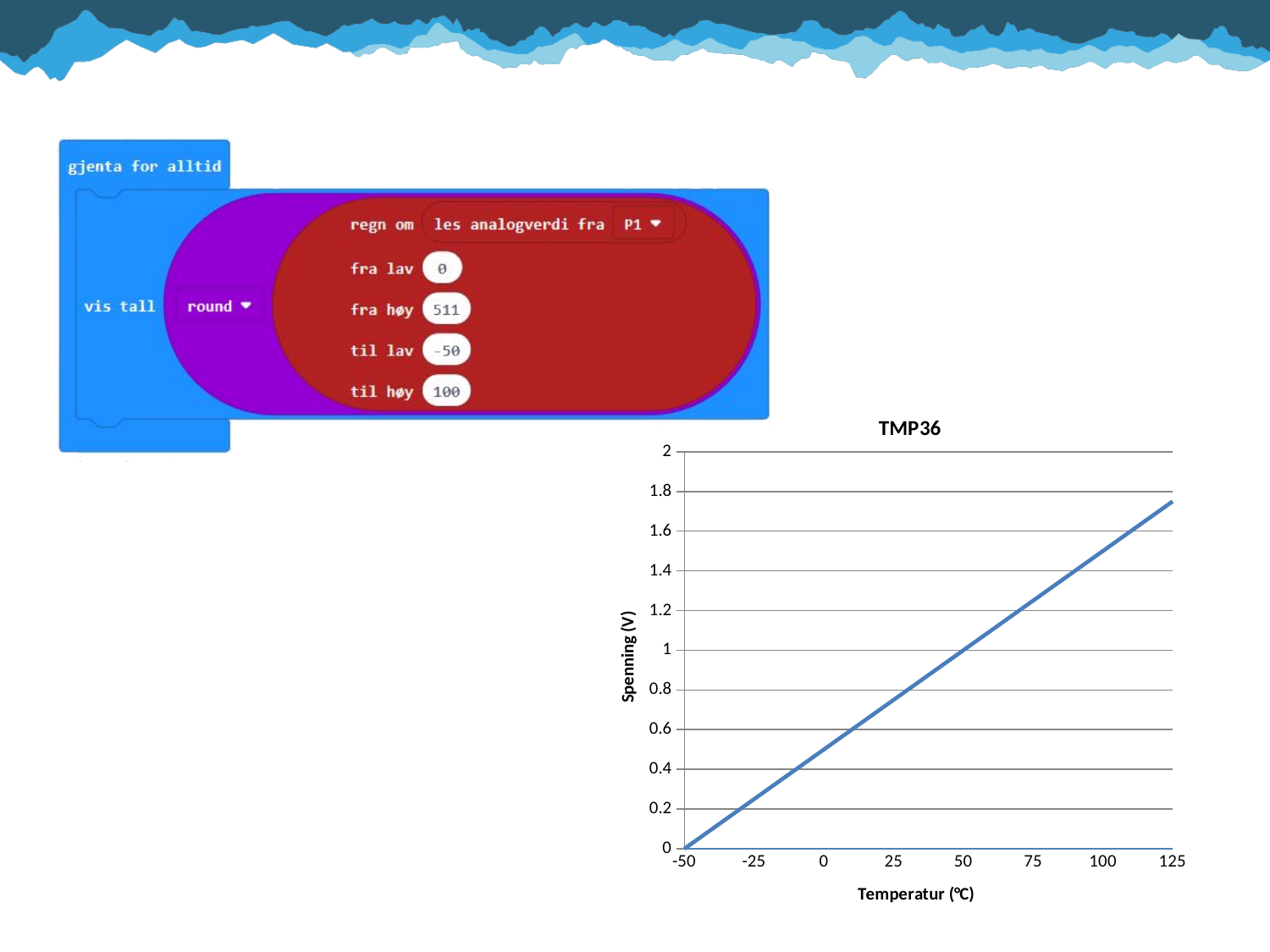
Does the voltage (Spenning) rise or fall as temperature increases along the x axis? rises Is the Spenning value at 125 °C greater or less than 1.8? less Is the Spenning value at 100 °C greater or less than 1.4? greater What is the title of the chart? TMP36 At which temperature on the x axis is the Spenning value lowest? -50 What is the Spenning (V) value at -50 °C on the TMP36 chart? 0 Which temperature has the higher Spenning value, 25 °C or 75 °C? 75 °C What kind of chart is shown on the slide? line chart Is the Spenning value at 0 °C greater or less than 0.4? greater What is the label of the x axis of the TMP36 chart? Temperatur (°C) What is the Spenning (V) value at 50 °C on the TMP36 chart? 1